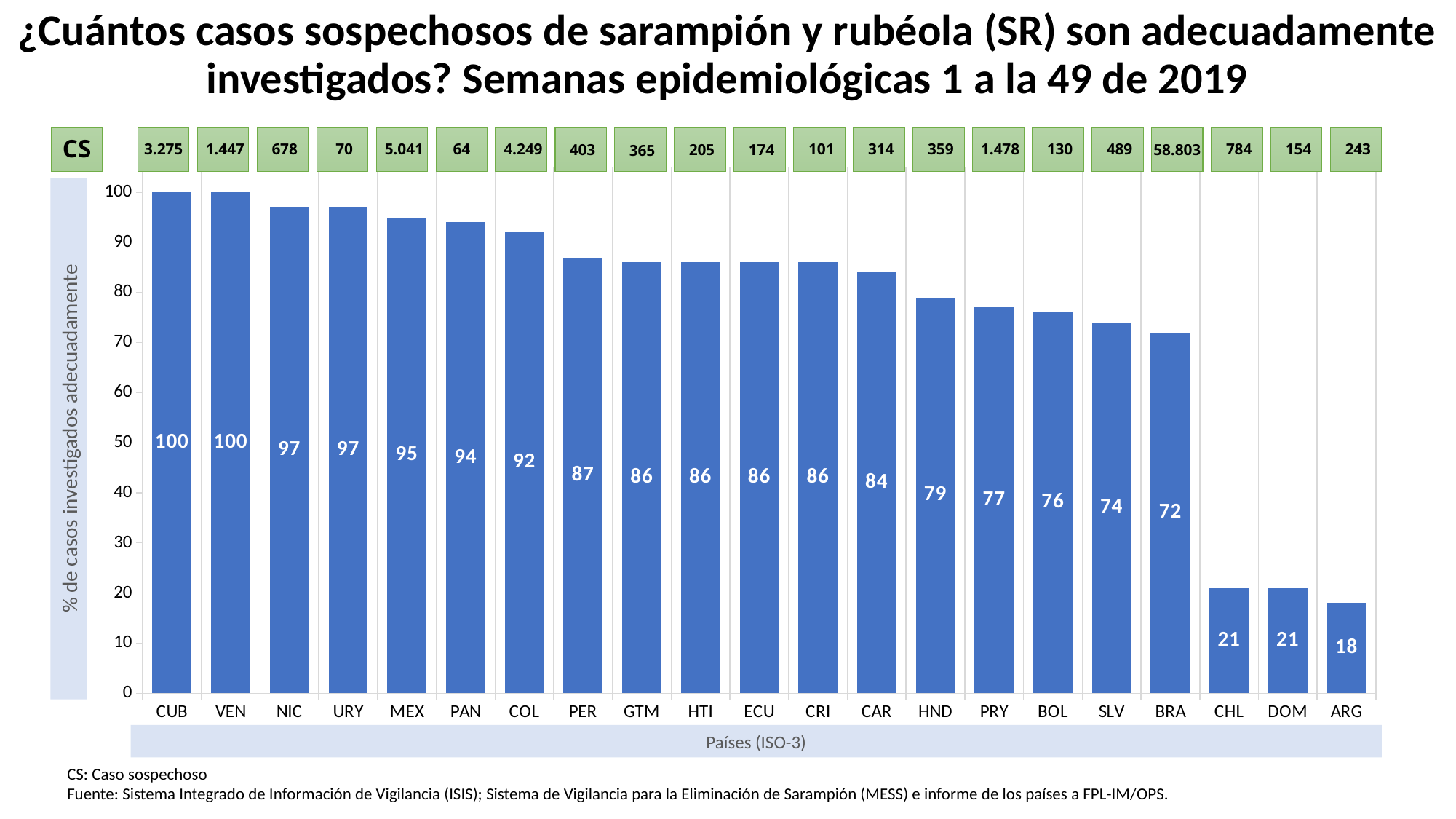
What is the difference between the values for COL and SLV? 18 What is the value for HND? 79 What is the value for BRA? 72 What is the label of the x axis? Países (ISO-3) What kind of chart is this? bar chart Which is larger, the value for PAN or the value for PRY? PAN Do the values rise or fall from left to right along the x axis? fall Which country has the lowest value? ARG How many countries are shown on the x axis? 21 Is the value for CAR greater or less than 80? greater What is the CS (suspected cases) number shown above the bar for BRA? 58.803 What is the value for MEX? 95